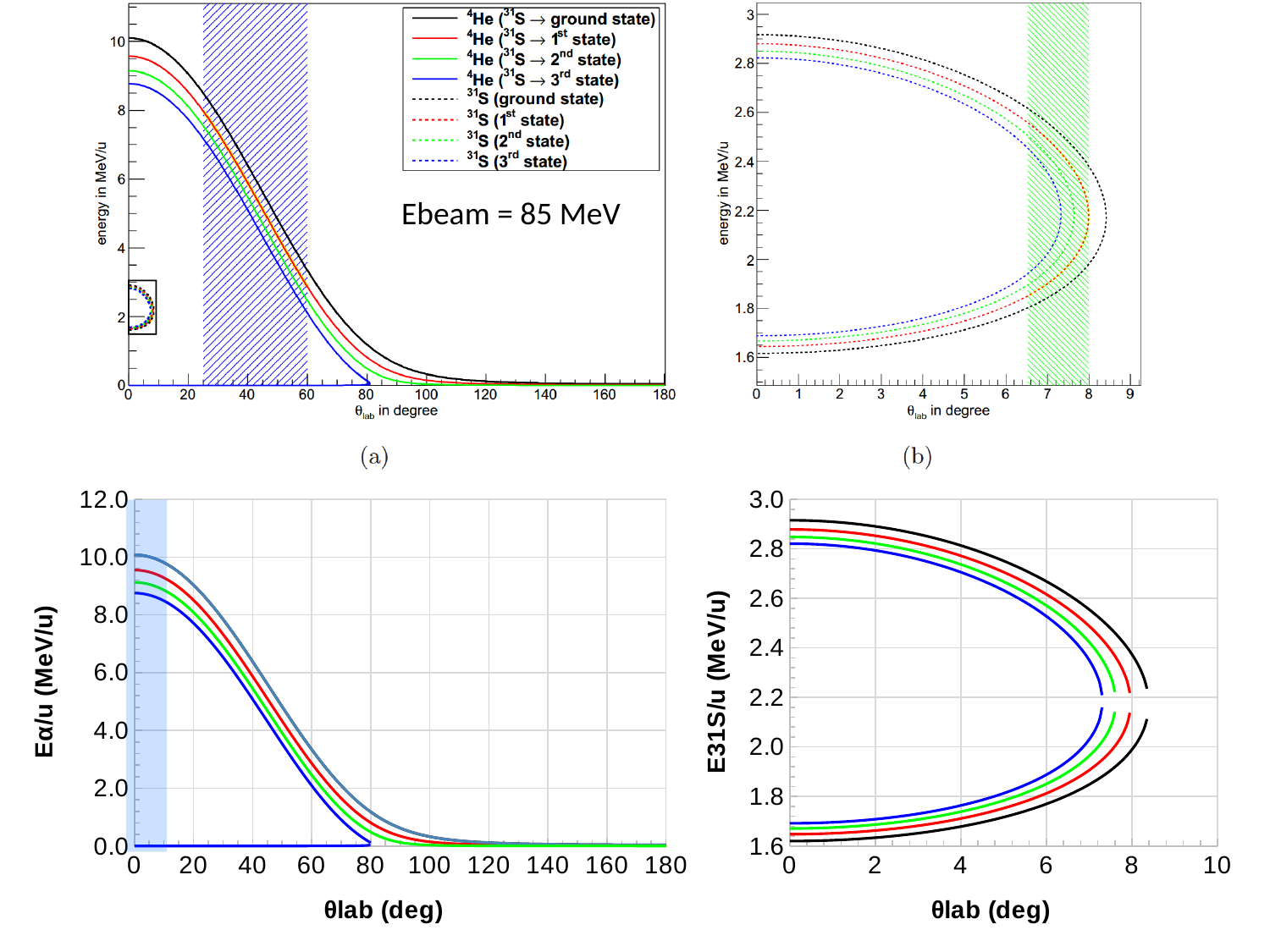
What kind of chart is the bottom-left chart? line chart What beam energy is annotated on the top-left chart (a)? Ebeam = 85 MeV In the bottom-right chart, is the largest θlab reached by the black curve greater or less than 8? greater How many charts are shown on the slide? 4 In the bottom-right chart, is the minimum value of the black curve greater or less than 1.8? less In the bottom-left chart, is the maximum value of Eα/u greater or less than 8.0? greater In the bottom-left chart, at θlab = 0, which curve is higher, the red one or the green one? red In the bottom-left chart, do the Eα/u values rise or fall as θlab increases? fall How many series does the legend of the top-left chart (a) list? 8